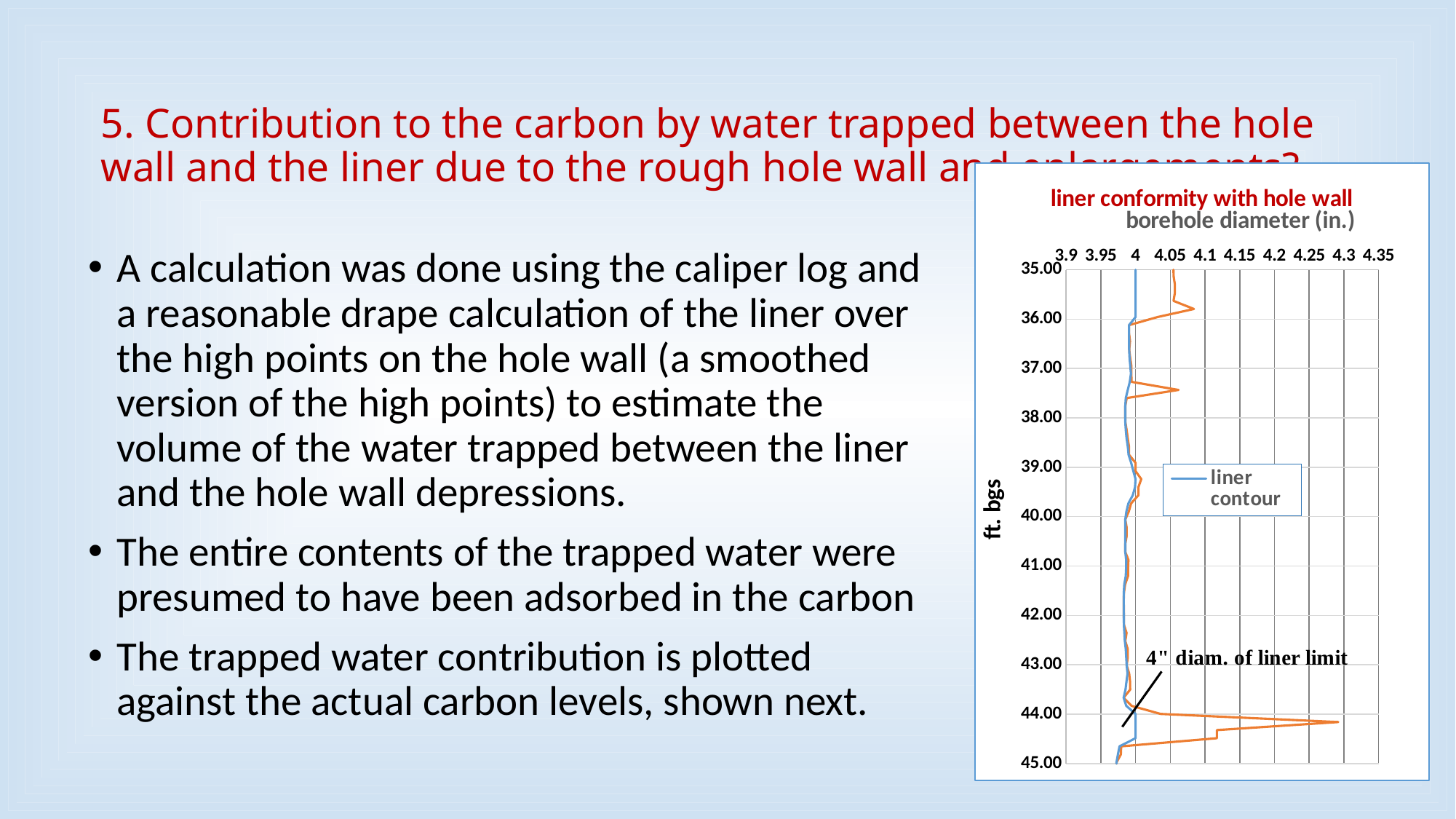
What type of chart is shown on the slide? line chart What is the label of the vertical axis of the chart? ft. bgs How many series does the chart legend list? 1 How many tick labels are shown on the vertical (depth) axis of the chart? 11 Is the value of the liner series at 40.00 ft bgs greater or less than 4.05? less How many tick labels are shown on the horizontal (diameter) axis of the chart? 10 What is the label of the horizontal axis of the chart? borehole diameter (in.) What is the title of the chart? liner conformity with hole wall